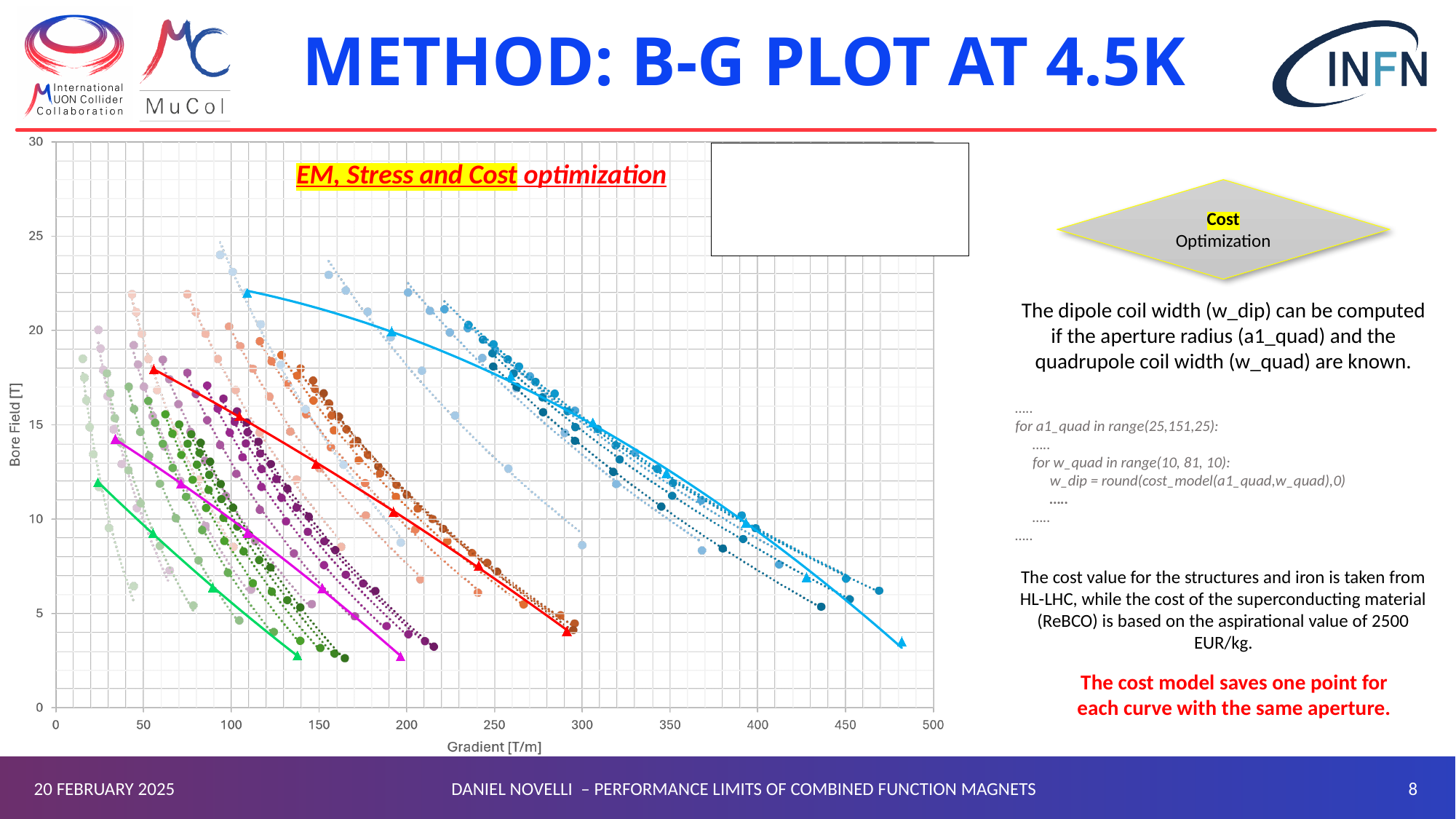
How many solid curves with triangle markers are drawn on the chart? 4 Which solid curve starts at the lowest bore field: the cyan, red, magenta or green one? Green What kind of chart is shown on the slide? Scatter chart with fitted lines What quantity is plotted on the y axis of the chart? Bore Field [T] Is the gradient at the rightmost triangle of the green solid curve greater or less than 150 T/m? less Which solid curve reaches a higher bore field at its leftmost triangle, the red one or the magenta one? Red Is the bore field at the leftmost triangle of the cyan solid curve greater or less than 20 T? greater Is the bore field at the leftmost triangle of the red solid curve greater or less than 15 T? greater What quantity is plotted on the x axis of the chart? Gradient [T/m] As the gradient increases along the x axis, does the bore field of each curve rise or fall? Fall Which solid curve reaches the highest gradient on the chart: the cyan, red, magenta or green one? Cyan